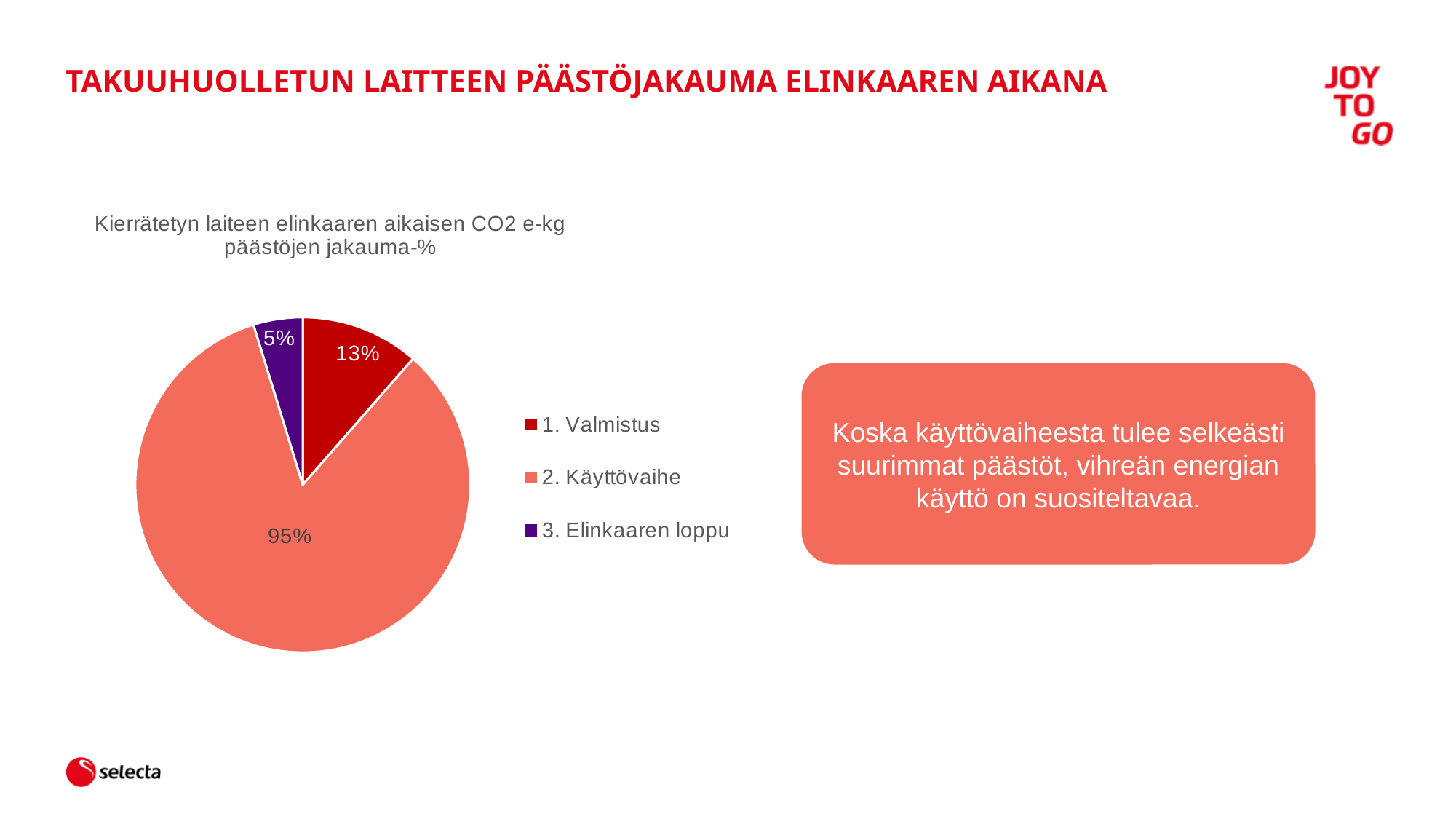
What is the difference in percentage points between 1. Valmistus and 3. Elinkaaren loppu? 8% Which is larger, the slice for 1. Valmistus or the slice for 3. Elinkaaren loppu? 1. Valmistus What kind of chart is shown on the slide? pie chart Which category has the largest slice of the pie? 2. Käyttövaihe What percentage is shown for 2. Käyttövaihe? 95% What percentage is shown for 3. Elinkaaren loppu? 5% What percentage is shown for 1. Valmistus? 13% How many categories does the pie chart have? 3 Which category has the smallest slice of the pie? 3. Elinkaaren loppu What colour is the slice for 3. Elinkaaren loppu? purple What is the title of the chart? Kierrätetyn laiteen elinkaaren aikaisen CO2 e-kg päästöjen jakauma-% What share of the pie does 2. Käyttövaihe represent? 95%